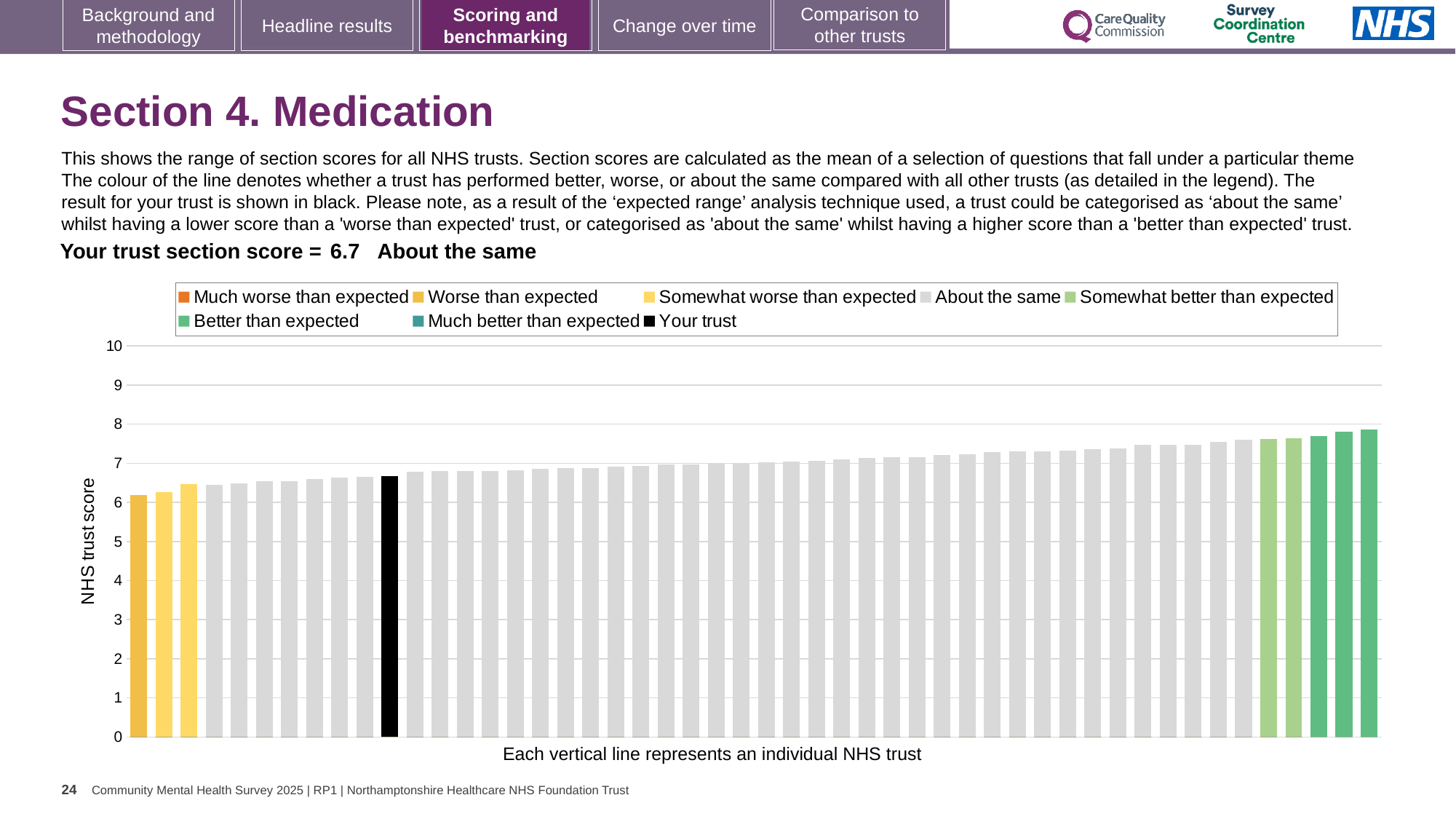
Is the value of the black bar (your trust) greater or less than 7? less What is the section score for your trust shown on the chart? 6.7 What colour is the bar representing your trust? black Is the value of the tallest bar greater or less than 7? greater Is the value of the tallest bar greater or less than 8? less Do the bar values rise or fall from left to right along the x axis? rise What kind of chart is shown on the slide? bar chart Which is larger, the value of the rightmost bar or the value of the black bar? the rightmost bar How many entries does the chart legend list? 8 What is the label on the vertical axis of the chart? NHS trust score